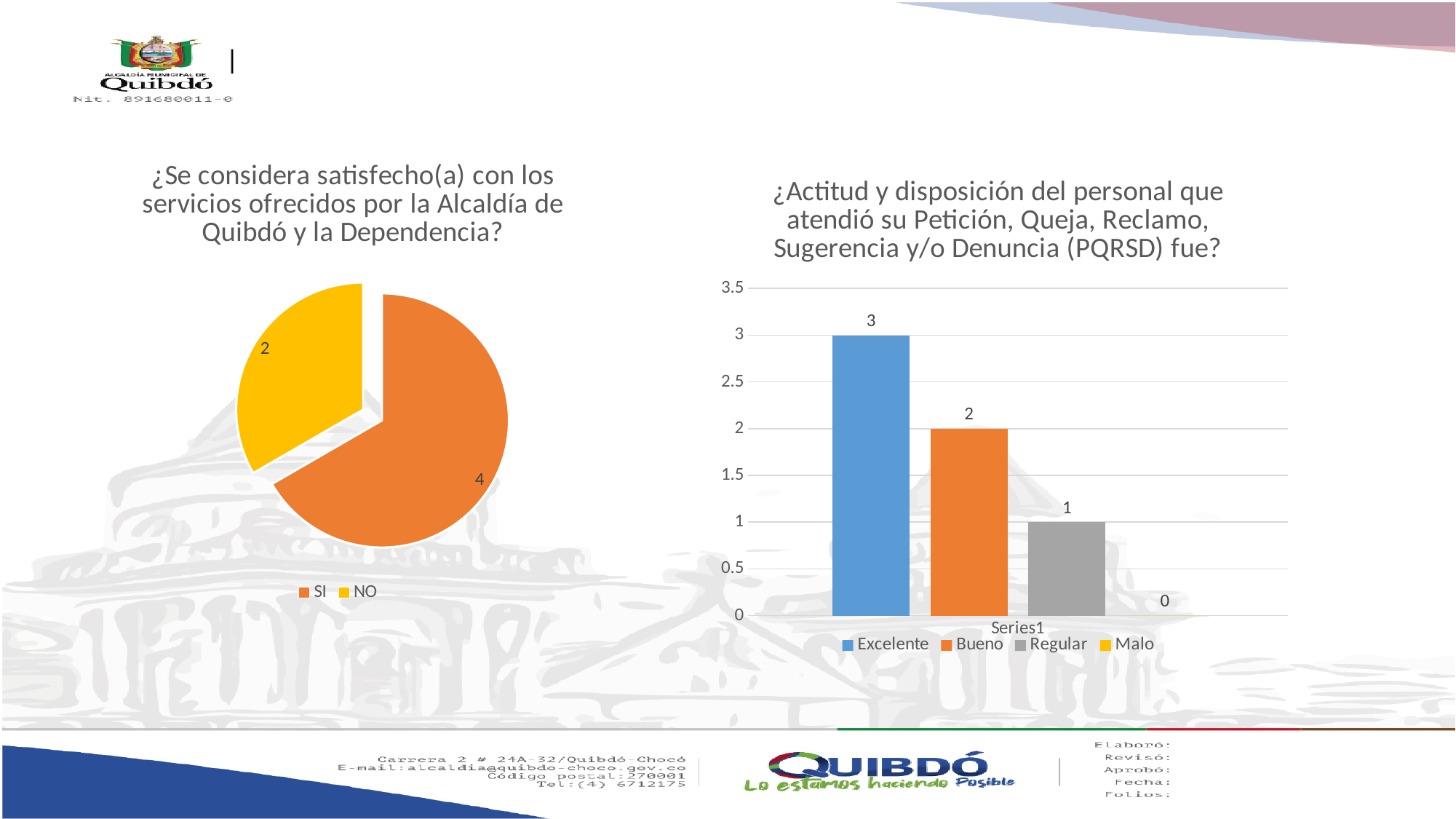
In the bar chart on the right, what is the value for Excelente? 3 In the bar chart on the right, how many series does the legend list? 4 In the pie chart on the left, what is the value for NO? 2 In the pie chart on the left, how many categories does the legend list? 2 In the pie chart on the left, what is the value for SI? 4 In the pie chart on the left, what is the difference between the SI and NO values? 2 In the bar chart on the right, what colour is the Bueno bar? orange In the bar chart on the right, what is the difference between Excelente and Bueno? 1 In the bar chart on the right, what is the value for Regular? 1 In the pie chart on the left, which category has the larger slice? SI What kind of chart is the chart on the left? pie chart In the bar chart on the right, which category has the lowest value? Malo